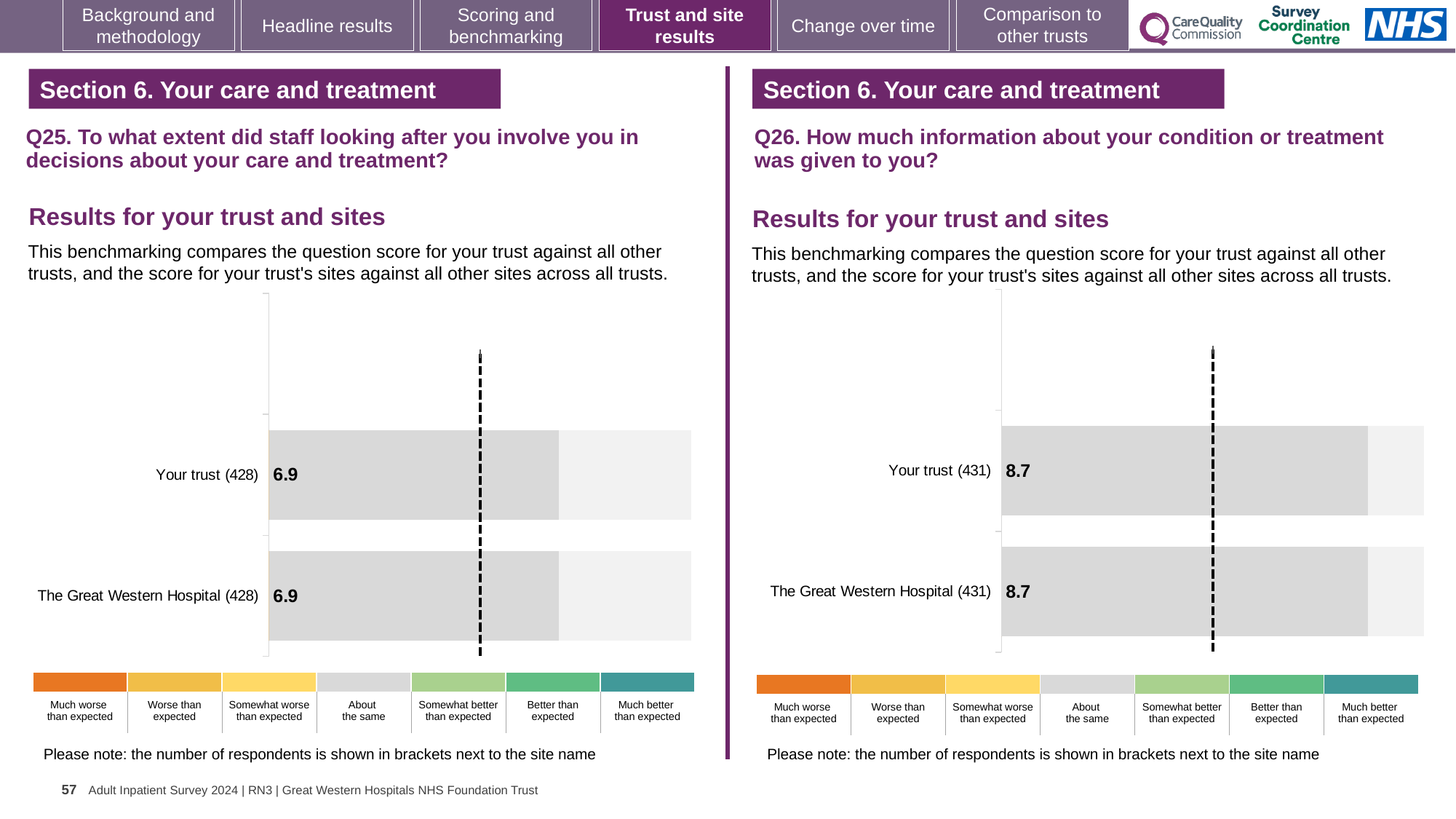
How many bars are plotted on the Q26 chart (right)? 2 Is the score for Your trust on the Q26 chart (right) larger or smaller than the score for Your trust on the Q25 chart (left)? Larger On the Q25 chart (left), what is the difference between the score for Your trust and the score for The Great Western Hospital? 0 On the Q25 chart (left), what is the score for The Great Western Hospital? 6.9 On the Q26 chart (right), what is the difference between the score for Your trust and the score for The Great Western Hospital? 0 On the Q26 chart (right), what is the score for Your trust? 8.7 On the Q25 chart (left), what is the score for Your trust? 6.9 How many bars are plotted on the Q25 chart (left)? 2 On the Q25 chart (left), how many respondents are shown in brackets next to Your trust? 428 On the Q26 chart (right), how many respondents are shown in brackets next to The Great Western Hospital? 431 What kind of chart is used on the Q25 chart (left)? Bar chart On the Q26 chart (right), what is the score for The Great Western Hospital? 8.7